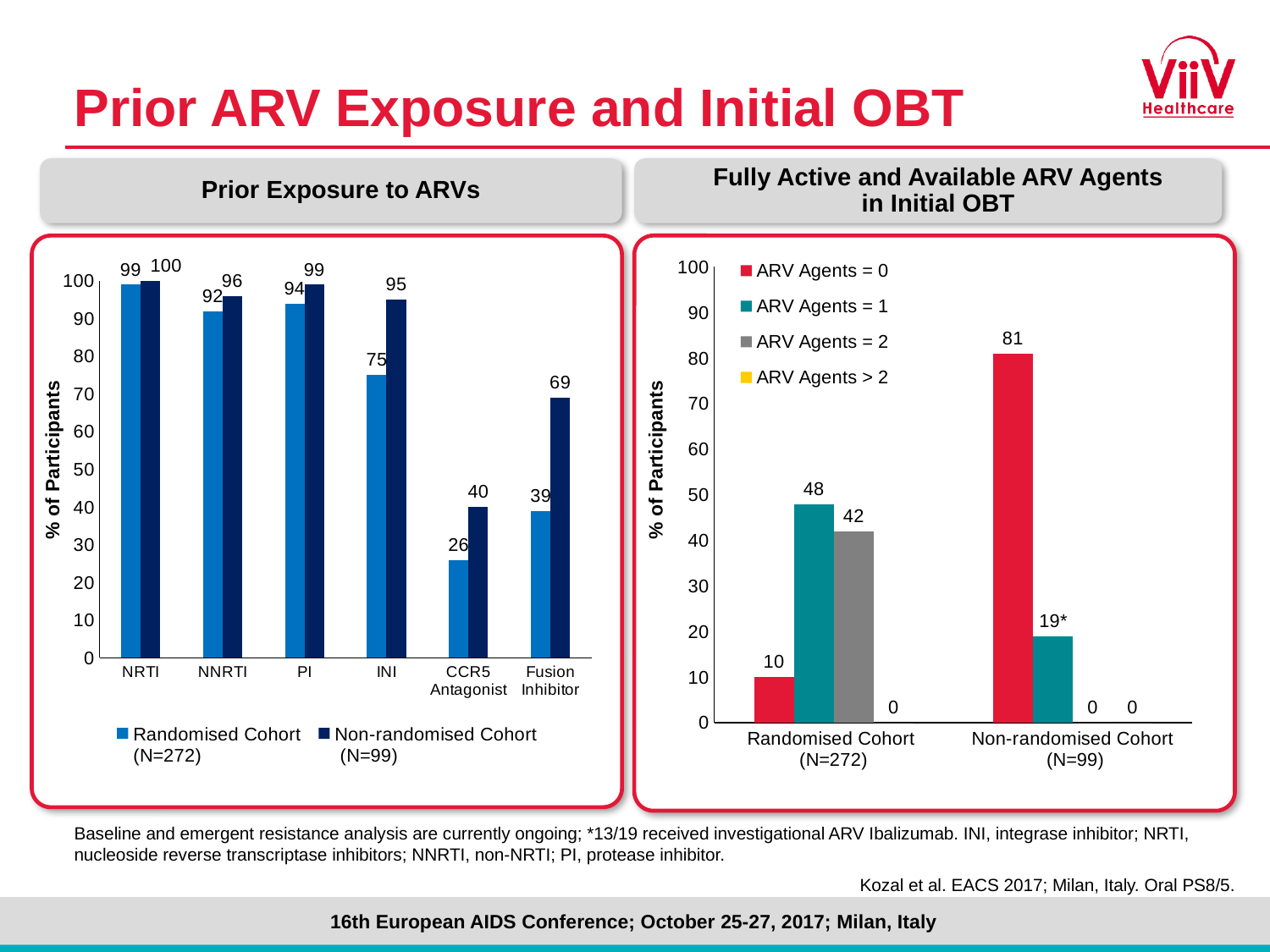
In the 'Prior Exposure to ARVs' chart, what is the value for Fusion Inhibitor in the Non-randomised Cohort? 69 What kind of chart is the 'Fully Active and Available ARV Agents in Initial OBT' chart? Bar chart In the 'Prior Exposure to ARVs' chart, what is the difference between the Non-randomised Cohort and Randomised Cohort values for INI? 20 In the 'Prior Exposure to ARVs' chart, which is larger for CCR5 Antagonist: the Randomised Cohort or the Non-randomised Cohort? Non-randomised Cohort In the 'Fully Active and Available ARV Agents in Initial OBT' chart, what is the difference between ARV Agents = 1 and ARV Agents = 0 in the Randomised Cohort? 38 In the 'Fully Active and Available ARV Agents in Initial OBT' chart, what is the value for ARV Agents = 2 in the Randomised Cohort? 42 In the 'Prior Exposure to ARVs' chart, what is the y-axis label? % of Participants In the 'Prior Exposure to ARVs' chart, how many categories are shown on the x axis? 6 In the 'Prior Exposure to ARVs' chart, which category has the lowest value for the Randomised Cohort? CCR5 Antagonist In the 'Fully Active and Available ARV Agents in Initial OBT' chart, what is the value for ARV Agents = 0 in the Non-randomised Cohort? 81 In the 'Prior Exposure to ARVs' chart, what is the value for INI in the Randomised Cohort? 75 In the 'Fully Active and Available ARV Agents in Initial OBT' chart, how many series does the legend list? 4